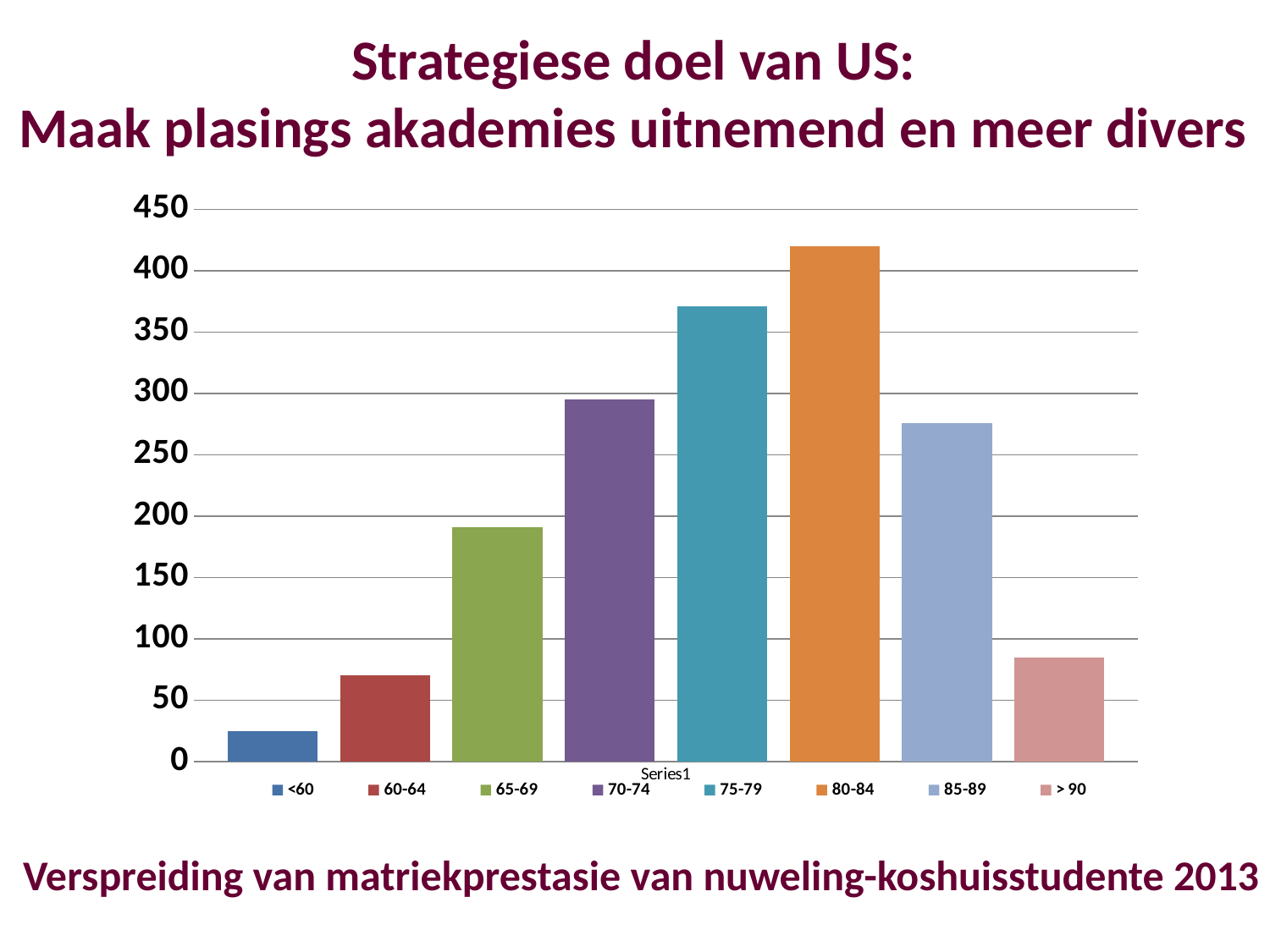
Is the value for 85-89 greater or less than 250? greater Is the value for > 90 greater or less than 100? less Is the value for 80-84 greater or less than 400? greater What kind of chart is shown on the slide? bar chart Which is larger, the value for 75-79 or the value for 85-89? 75-79 Which is larger, the value for 65-69 or the value for > 90? 65-69 Which category has the lowest bar? <60 Which category has the highest bar? 80-84 How many bars does the chart show? 8 What colour is the bar for 80-84? orange